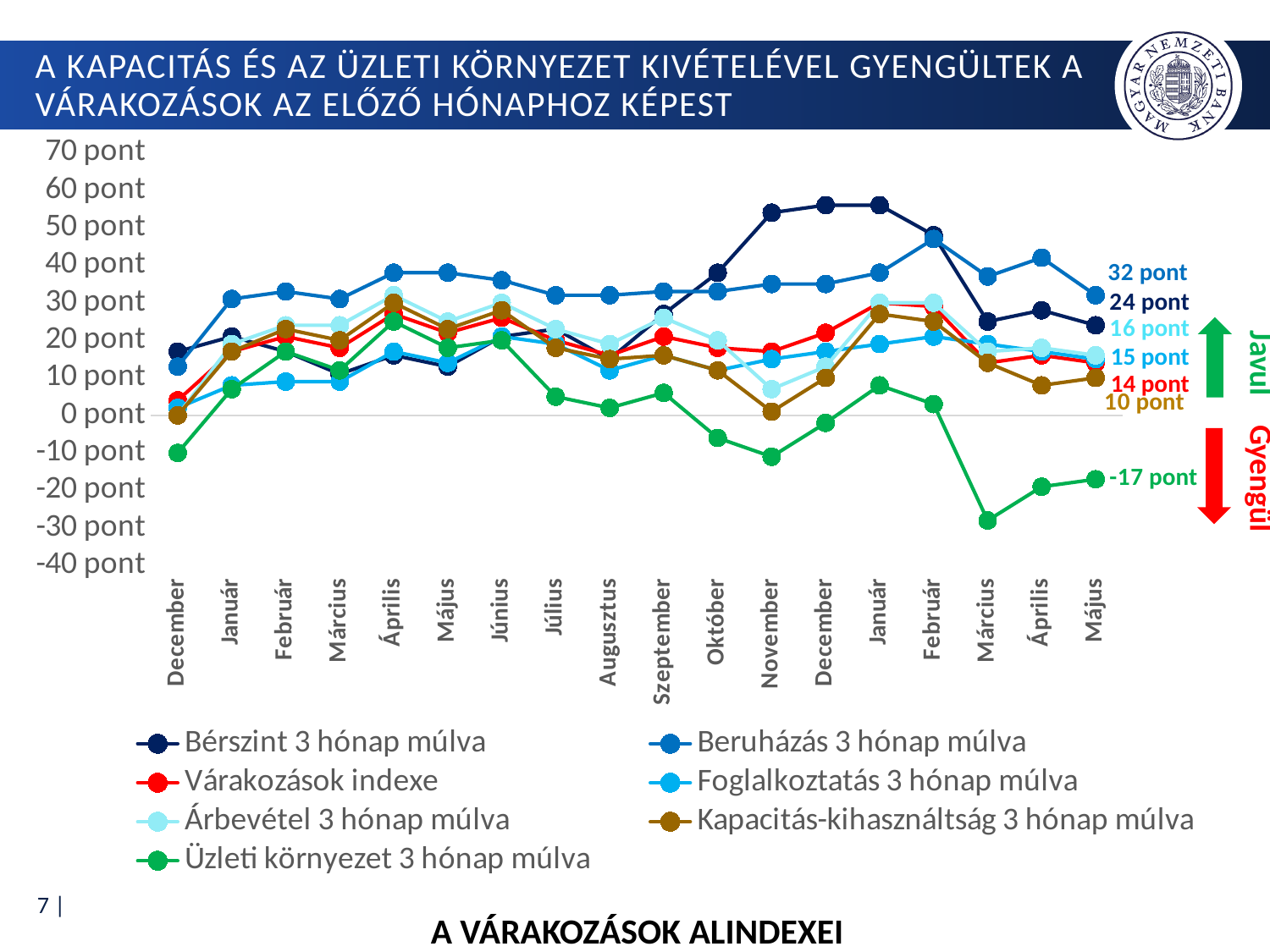
What is the value of Kapacitás-kihasználtság 3 hónap múlva in the final month (Május)? 10 pont How many series does the legend list? 7 What is the title printed below the chart? A VÁRAKOZÁSOK ALINDEXEI What is the value of Üzleti környezet 3 hónap múlva in the final month (Május)? -17 pont How many months are shown along the x axis? 18 In the final month (Május), which is larger: Várakozások indexe or Bérszint 3 hónap múlva? Bérszint 3 hónap múlva In the final month (Május), what is the difference between Beruházás 3 hónap múlva and Bérszint 3 hónap múlva? 8 pont What kind of chart is shown on the slide? line chart What is the value of Beruházás 3 hónap múlva in the final month (Május)? 32 pont Which series has the highest value in the final month (Május)? Beruházás 3 hónap múlva Which series has the lowest value in the final month (Május)? Üzleti környezet 3 hónap múlva